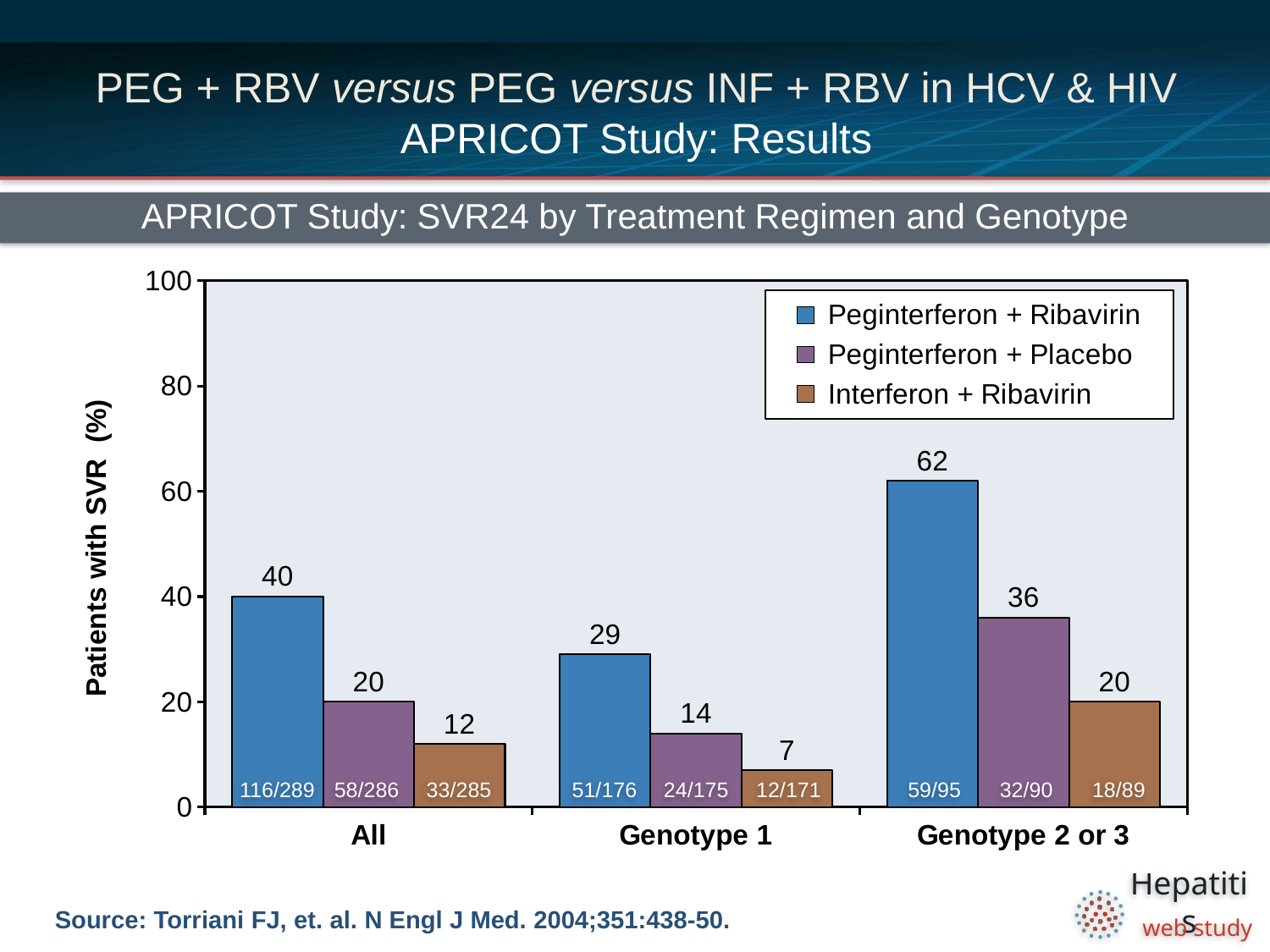
What is the SVR rate for Peginterferon + Ribavirin in the All group? 40 What is the difference in SVR rate between Peginterferon + Ribavirin and Peginterferon + Placebo in the All group? 20 Which is larger: the SVR rate for Peginterferon + Placebo in Genotype 2 or 3, or for Peginterferon + Ribavirin in Genotype 1? Peginterferon + Placebo in Genotype 2 or 3 What is the SVR rate for Peginterferon + Placebo in Genotype 2 or 3? 36 What kind of chart is shown on the slide? bar chart Which genotype group has the highest SVR rate for Peginterferon + Ribavirin? Genotype 2 or 3 Is the SVR rate for Peginterferon + Ribavirin in Genotype 2 or 3 greater or less than 60? greater Which treatment regimen has the lowest SVR rate in Genotype 1? Interferon + Ribavirin What is the y-axis label of the chart? Patients with SVR (%) What is the SVR rate for Interferon + Ribavirin in Genotype 1? 7 How many genotype categories are shown on the x axis? 3 How many treatment regimens does the legend list? 3